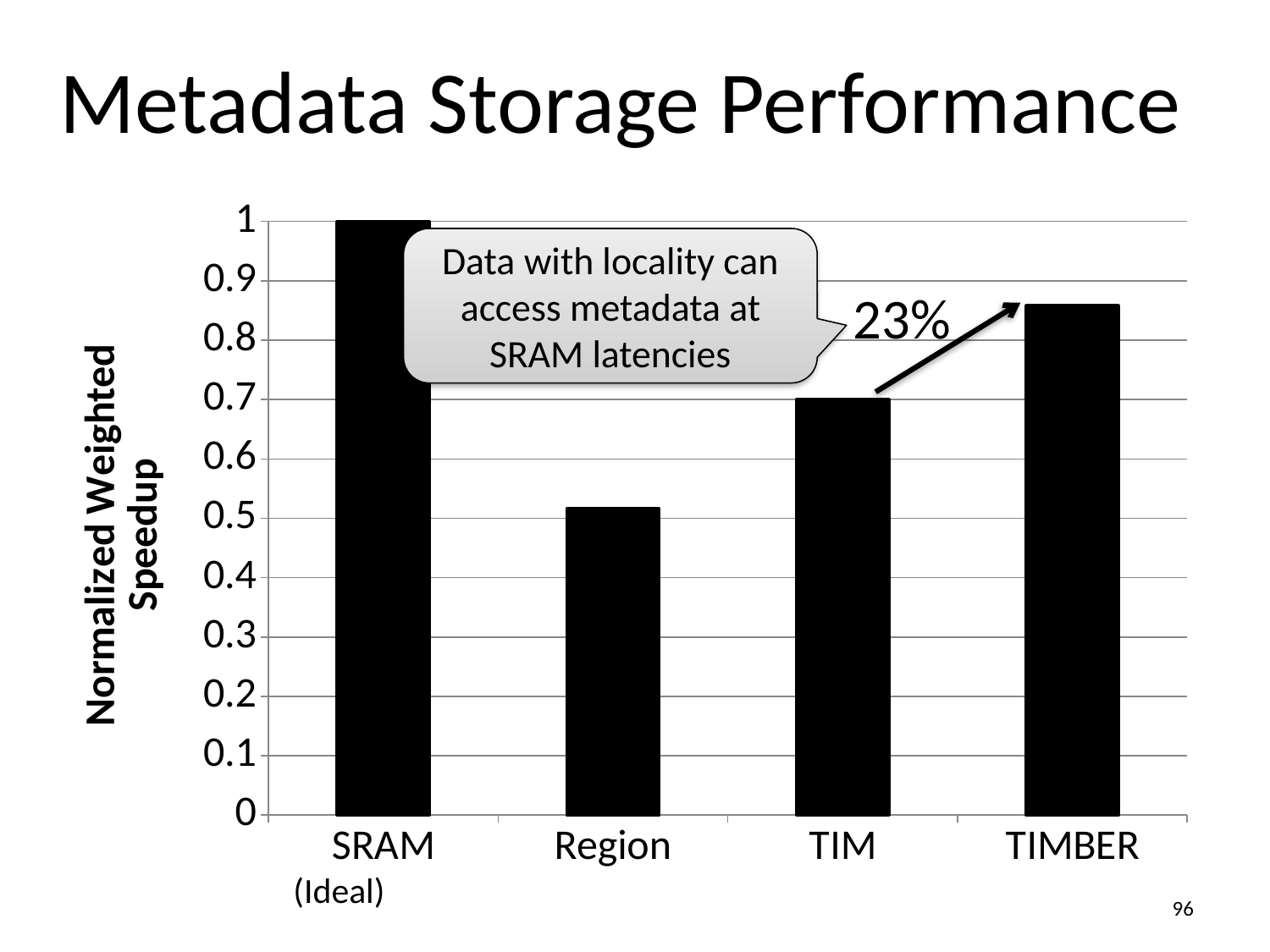
Is the value for Region greater or less than 0.6? less Which has a higher normalized weighted speedup, TIMBER or TIM? TIMBER Which category has the highest normalized weighted speedup? SRAM (Ideal) What percentage is annotated next to the arrow between the TIM and TIMBER bars? 23% What is the normalized weighted speedup for SRAM (Ideal)? 1 Is the value for TIMBER greater or less than 0.8? greater Which has a higher normalized weighted speedup, TIM or Region? TIM Is the value for TIM greater or less than 0.6? greater Which category has the lowest normalized weighted speedup? Region What kind of chart is shown on the slide? bar chart How many categories are shown on the x axis of the chart? 4 What is the label of the y axis? Normalized Weighted Speedup